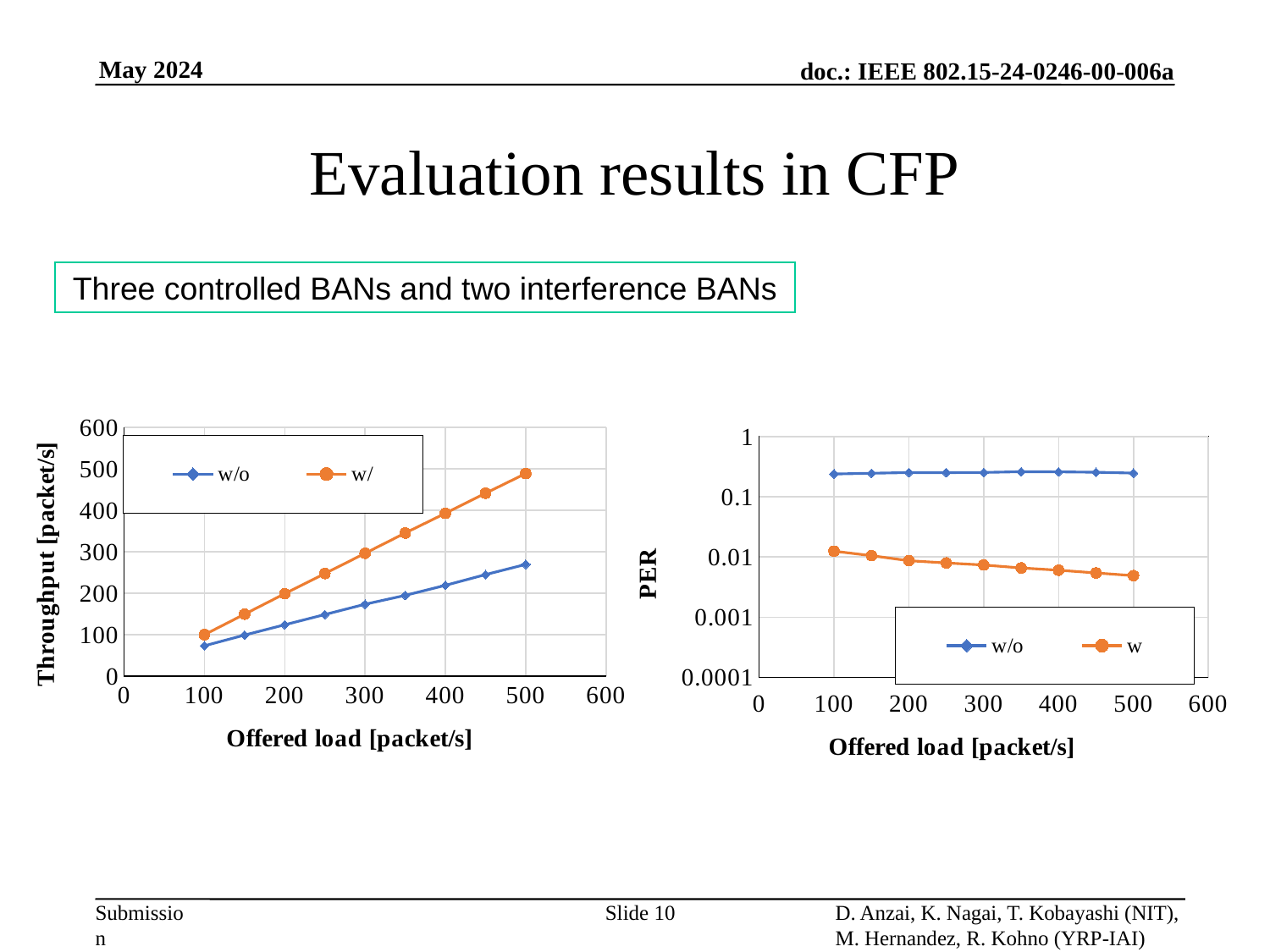
In the right chart (PER), is the PER of the w/o series at an offered load of 100 packet/s greater or less than 0.1? greater In the left chart (Throughput), is the throughput of the w/o series at an offered load of 500 packet/s greater or less than 300? less What is the y-axis title of the left chart? Throughput [packet/s] In the right chart (PER), at an offered load of 300 packet/s, which series has the higher PER, w/o or w? w/o What kind of chart is the left chart (Throughput vs Offered load)? line chart How many series does the legend of the right chart (PER) list? 2 In the left chart (Throughput), is the throughput of the w/ series at an offered load of 400 packet/s greater or less than 300? greater In the left chart (Throughput), how many data points are plotted for the w/ series? 9 In the left chart (Throughput), does the w/ series rise or fall as offered load increases? rise How many series does the legend of the left chart (Throughput) list? 2 In the left chart (Throughput), at an offered load of 500 packet/s, which series has the higher throughput, w/o or w/? w/ In the right chart (PER), does the w series rise or fall as offered load increases? fall